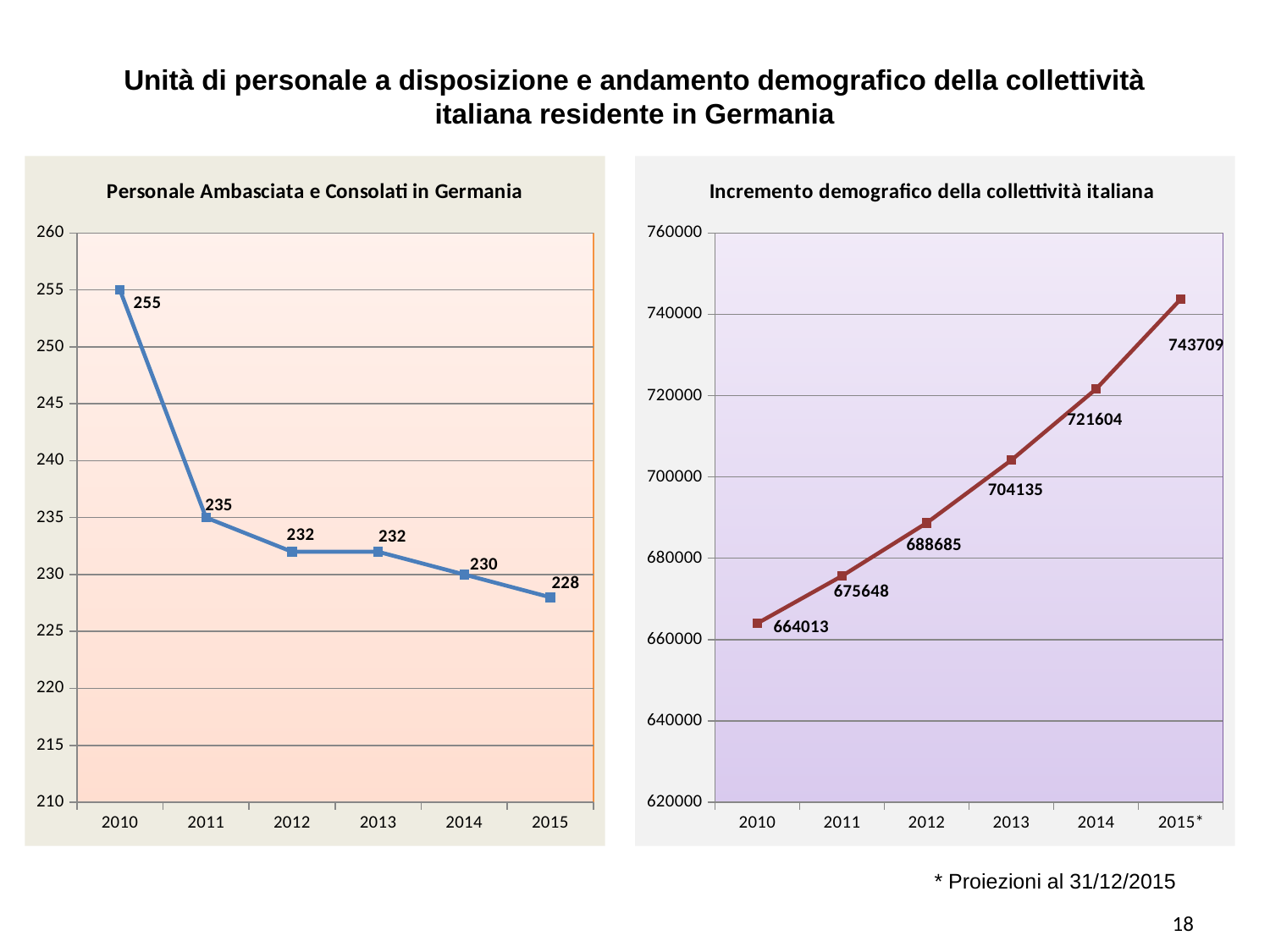
In the chart 'Incremento demografico della collettività italiana', what is the value for 2013? 704135 In the chart 'Incremento demografico della collettività italiana', which year has the lowest value? 2010 In the chart 'Incremento demografico della collettività italiana', is the value for 2012 greater or less than 700000? less In the chart 'Personale Ambasciata e Consolati in Germania', what is the difference between the values for 2010 and 2011? 20 What kind of chart is 'Personale Ambasciata e Consolati in Germania'? line chart In the chart 'Personale Ambasciata e Consolati in Germania', which year has the highest value? 2010 In the chart 'Incremento demografico della collettività italiana', what is the value for 2015*? 743709 In the chart 'Incremento demografico della collettività italiana', what is the difference between the values for 2014 and 2013? 17469 How many data points are plotted in the chart 'Incremento demografico della collettività italiana'? 6 In the chart 'Personale Ambasciata e Consolati in Germania', what is the value for 2015? 228 In the chart 'Personale Ambasciata e Consolati in Germania', what is the value for 2010? 255 In the chart 'Personale Ambasciata e Consolati in Germania', do the values rise or fall from 2010 to 2015? fall